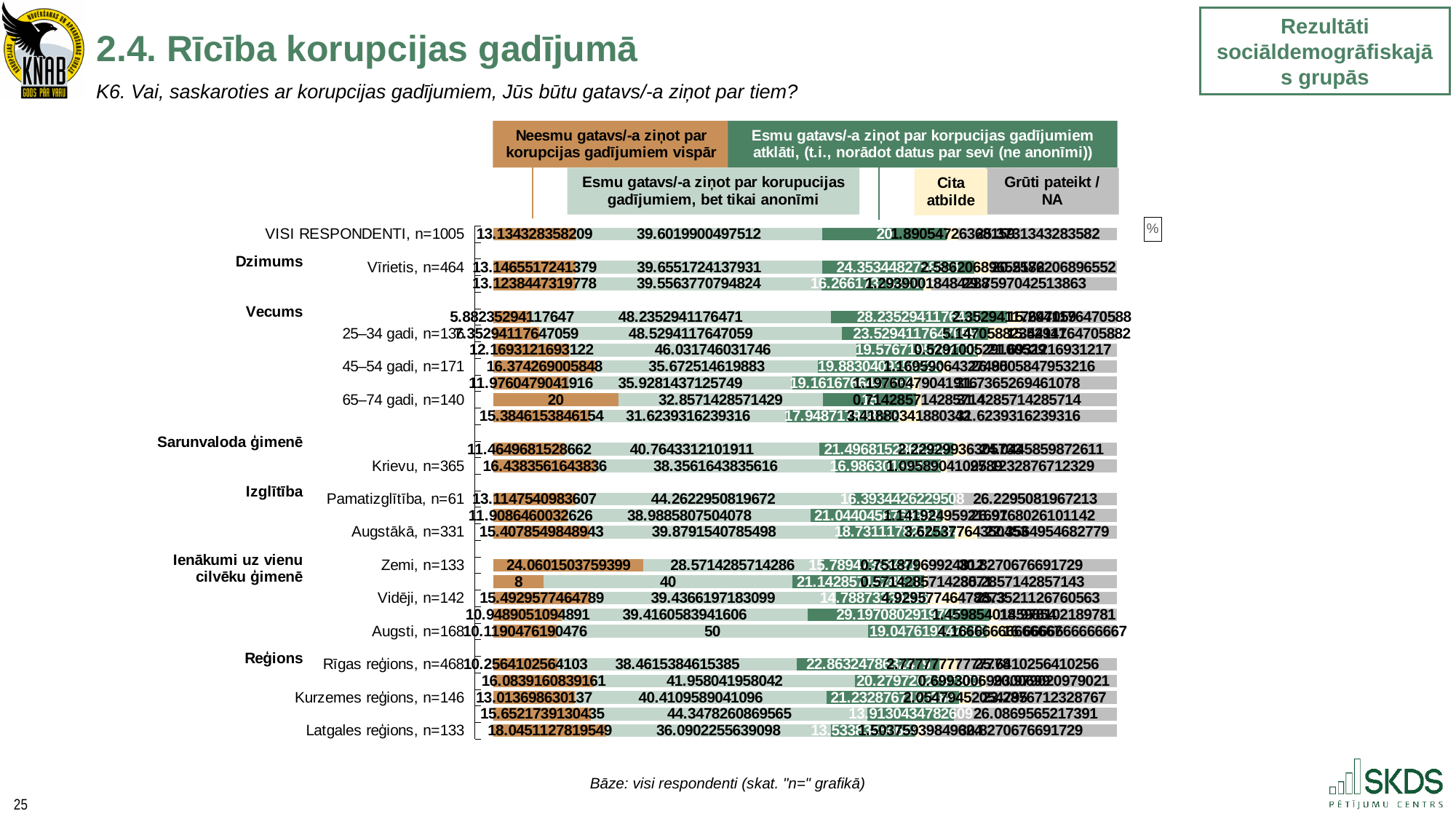
What is the value of the 'Neesmu gatavs/-a ziņot par korupcijas gadījumiem vispār' segment for 65–74 gadi, n=140? 20 Which has the larger 'Neesmu gatavs/-a ziņot par korupcijas gadījumiem vispār' value: Zemi, n=133 or Augsti, n=168? Zemi, n=133 What is the value of the 'Neesmu gatavs/-a ziņot par korupcijas gadījumiem vispār' segment for VISI RESPONDENTI, n=1005? 13.134328358209 What is the value of the 'Neesmu gatavs/-a ziņot par korupcijas gadījumiem vispār' segment for Zemi, n=133? 24.0601503759399 What is the difference between the 'Esmu gatavs/-a ziņot par korupcijas gadījumiem, bet tikai anonīmi' values for Augsti, n=168 and Zemi, n=133? 21.4285714285714 Which has the larger 'Neesmu gatavs/-a ziņot par korupcijas gadījumiem vispār' value: Vīrietis, n=464 or Krievu, n=365? Krievu, n=365 What is the value of the 'Esmu gatavs/-a ziņot par korupcijas gadījumiem, bet tikai anonīmi' segment for Augsti, n=168? 50 What is the value of the 'Esmu gatavs/-a ziņot par korupcijas gadījumiem, bet tikai anonīmi' segment for Kurzemes reģions, n=146? 40.4109589041096 What is the value of the 'Grūti pateikt / NA' segment for Pamatizglītība, n=61? 26.2295081967213 How many series does the legend list? 5 Among the Reģions groups, which has the highest 'Neesmu gatavs/-a ziņot par korupcijas gadījumiem vispār' value? Latgales reģions, n=133 What kind of chart is shown on the slide? Stacked bar chart